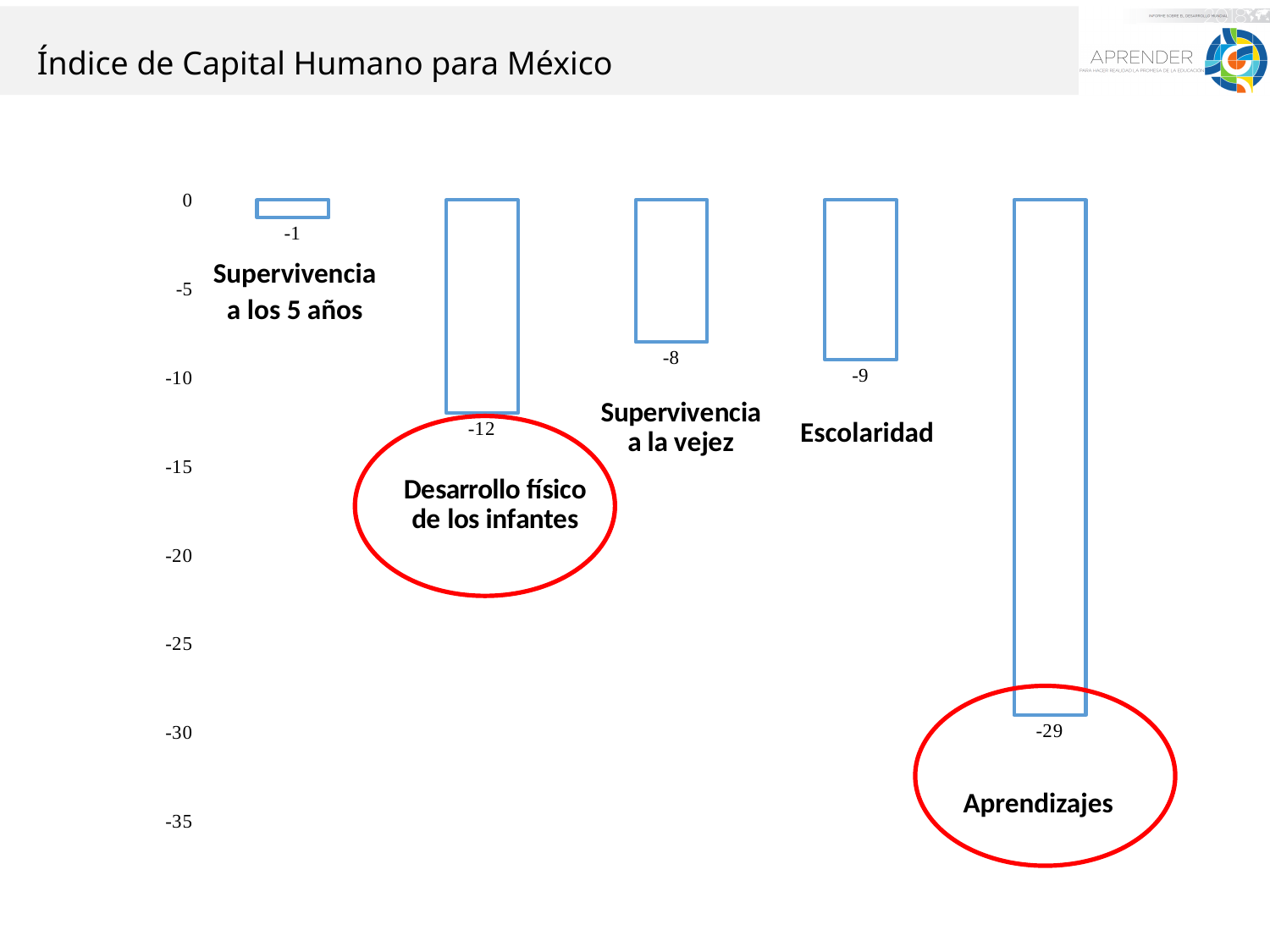
What is the value for Supervivencia a los 5 años? -1 Which category has the lowest (most negative) value? Aprendizajes Which has a more negative value, Escolaridad or Supervivencia a la vejez? Escolaridad What is the value for Aprendizajes? -29 How many categories are shown in the chart? 5 What is the title of the slide containing the chart? Índice de Capital Humano para México What is the value for Supervivencia a la vejez? -8 What is the value for Desarrollo físico de los infantes? -12 What is the difference between the values for Aprendizajes and Desarrollo físico de los infantes? 17 What is the value for Escolaridad? -9 What kind of chart is shown on the slide? Bar chart Which category has the highest value (closest to zero)? Supervivencia a los 5 años